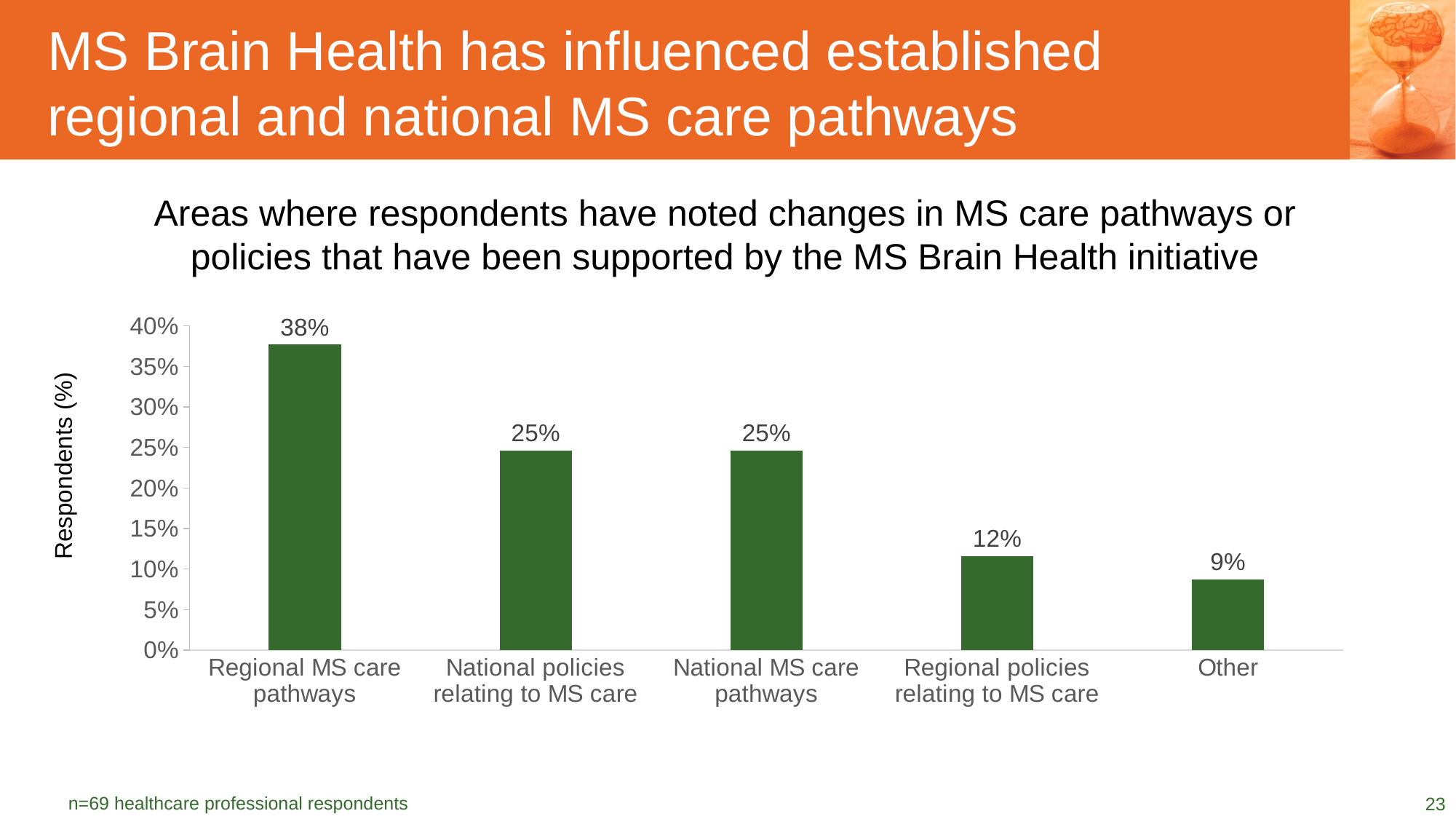
Which category has the lowest percentage of respondents? Other What is the value for Regional policies relating to MS care? 12% What percentage of respondents noted changes in Regional MS care pathways? 38% What kind of chart is shown on the slide? Bar chart What is the difference between the values for Regional policies relating to MS care and Other? 3% Which category has the highest percentage of respondents? Regional MS care pathways Which is larger: the value for National policies relating to MS care or the value for Regional policies relating to MS care? National policies relating to MS care How many categories are shown on the x axis? 5 What is the label of the y axis? Respondents (%) What is the maximum value shown on the y axis? 40% What is the difference between the values for Regional MS care pathways and National MS care pathways? 13% What is the value for the Other category? 9%